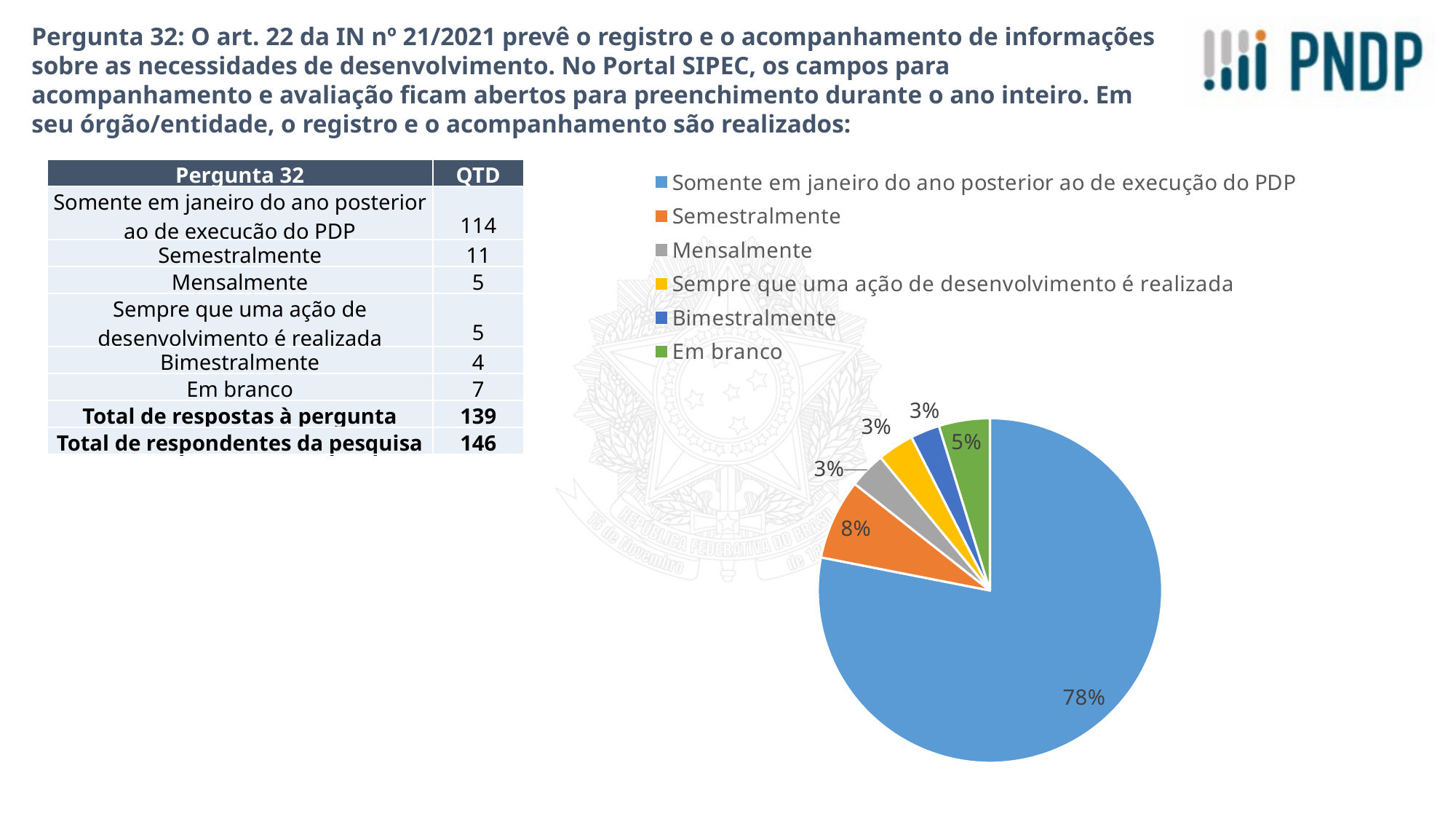
What kind of chart is shown on the slide? pie chart What percentage is shown for the "Em branco" slice of the pie chart? 5% What share of the pie does the slice for "Somente em janeiro do ano posterior ao de execução do PDP" represent? 78% What colour is the "Semestralmente" slice in the pie chart? orange What percentage is shown for the "Bimestralmente" slice of the pie chart? 3% How many entries does the legend of the pie chart list? 6 Which category has the largest slice in the pie chart? Somente em janeiro do ano posterior ao de execução do PDP How many slices does the pie chart have? 6 What percentage is shown for the "Mensalmente" slice of the pie chart? 3% What is the difference in percentage points between the "Somente em janeiro do ano posterior ao de execução do PDP" slice and the "Semestralmente" slice? 70 percentage points Which slice is larger in the pie chart, "Semestralmente" or "Em branco"? Semestralmente What percentage is shown for the "Semestralmente" slice of the pie chart? 8%